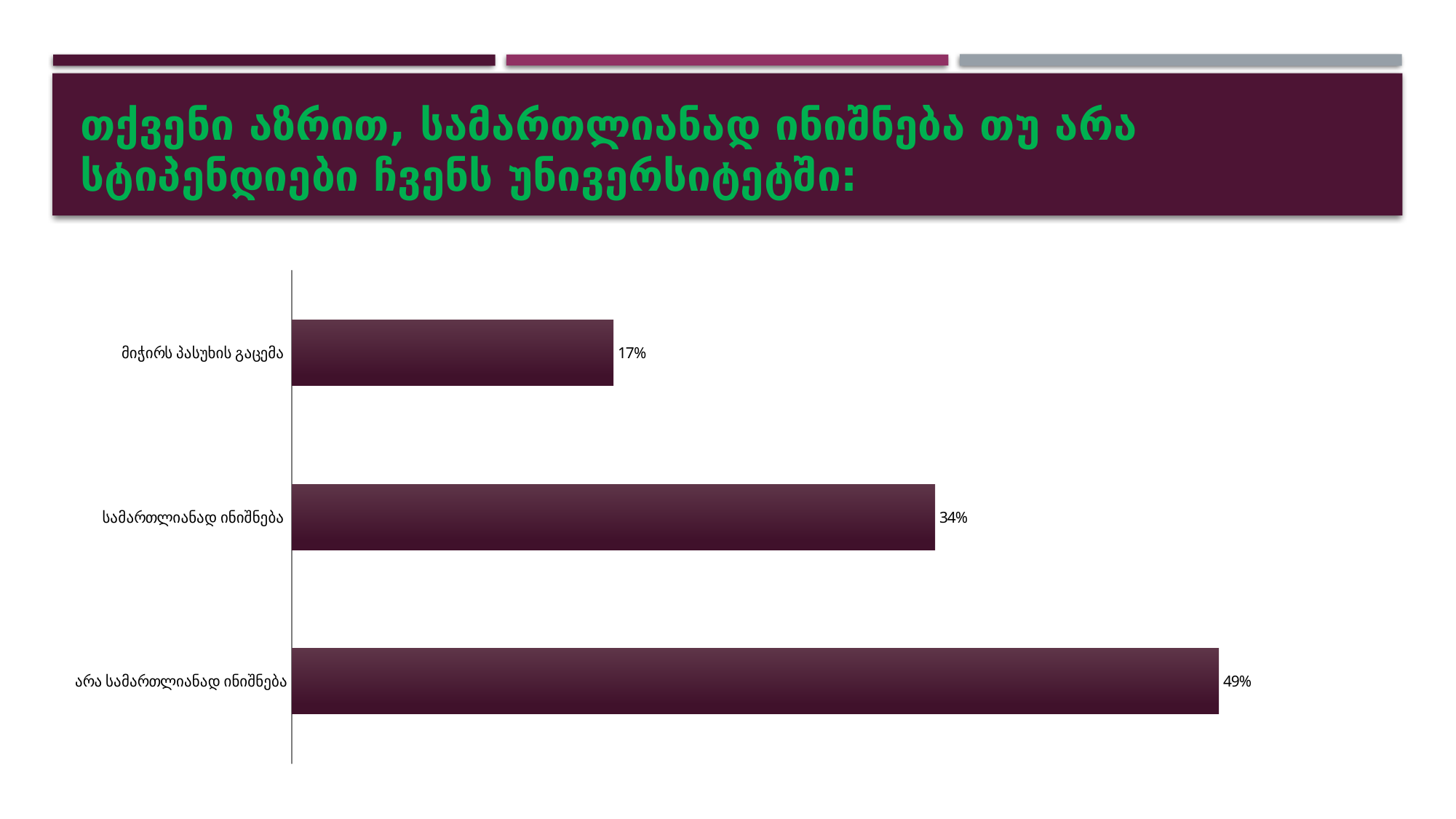
Which category has the highest value? არა სამართლიანად ინიშნება What is the difference between the values for "არა სამართლიანად ინიშნება" and "სამართლიანად ინიშნება"? 15% Are the bars in the chart horizontal or vertical? horizontal What kind of chart is shown on the slide? bar chart Which is larger, the value for "სამართლიანად ინიშნება" or the value for "მიჭირს პასუხის გაცემა"? სამართლიანად ინიშნება What is the difference between the values for "სამართლიანად ინიშნება" and "მიჭირს პასუხის გაცემა"? 17% What is the total of the three values shown in the chart? 100% What is the value for "არა სამართლიანად ინიშნება"? 49% What is the value for "სამართლიანად ინიშნება"? 34% What is the value for "მიჭირს პასუხის გაცემა"? 17% Which category has the lowest value? მიჭირს პასუხის გაცემა How many categories are shown in the chart? 3